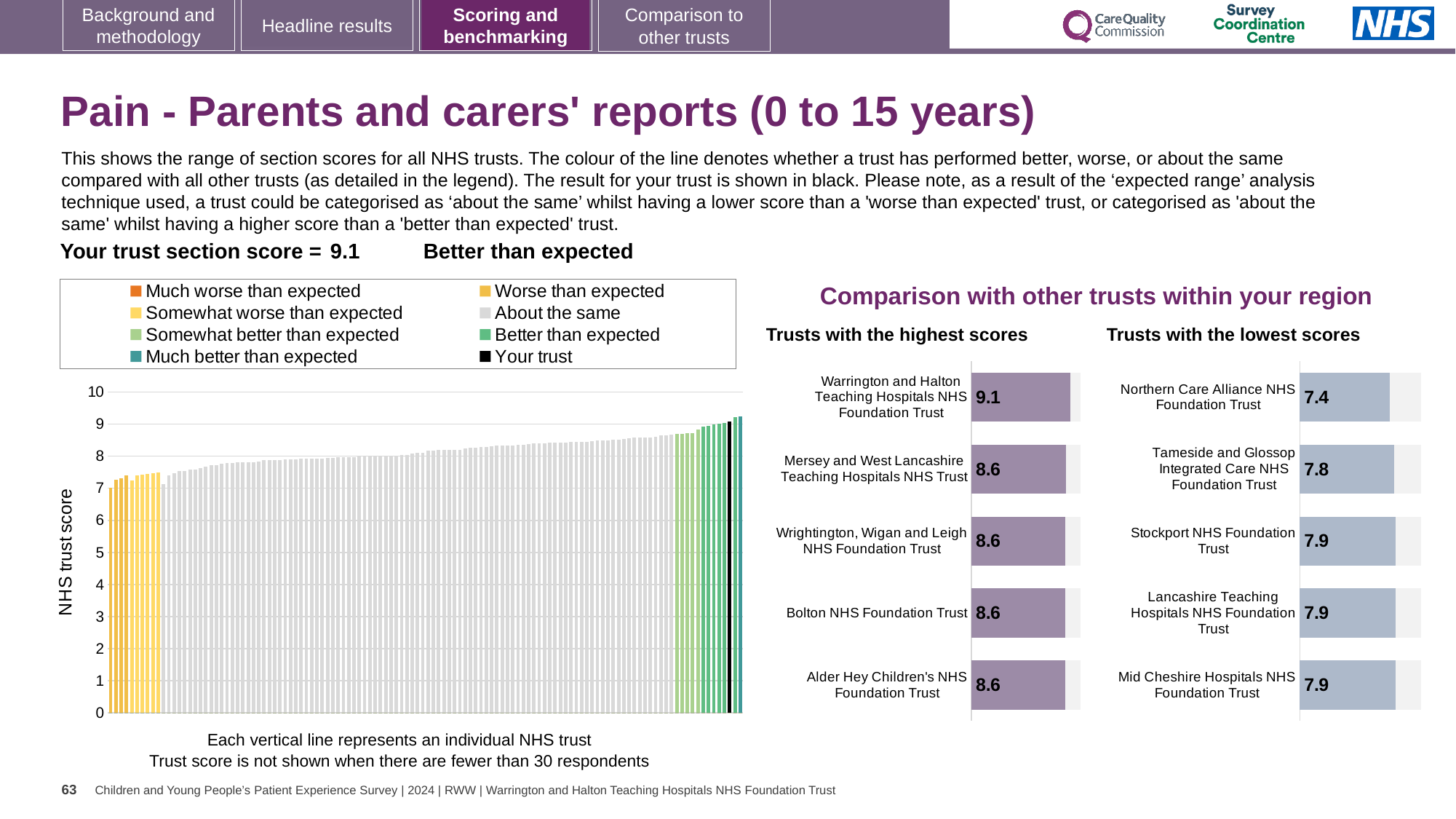
In the large chart on the left showing the range of section scores, are the values for the yellow (worse than expected) bars greater or less than 8? less How many entries does the legend of the large chart on the left list? 8 In the 'Trusts with the lowest scores' chart, which has the larger score: Stockport NHS Foundation Trust or Northern Care Alliance NHS Foundation Trust? Stockport NHS Foundation Trust In the 'Trusts with the lowest scores' chart, what is the score for Tameside and Glossop Integrated Care NHS Foundation Trust? 7.8 In the 'Trusts with the highest scores' chart, which trust has the highest score? Warrington and Halton Teaching Hospitals NHS Foundation Trust In the 'Trusts with the highest scores' chart, what is the score for Warrington and Halton Teaching Hospitals NHS Foundation Trust? 9.1 In the 'Trusts with the lowest scores' chart, which trust has the lowest score? Northern Care Alliance NHS Foundation Trust In the 'Trusts with the highest scores' chart, what is the score for Bolton NHS Foundation Trust? 8.6 In the 'Trusts with the lowest scores' chart, what is the score for Northern Care Alliance NHS Foundation Trust? 7.4 How many trusts are shown in the 'Trusts with the lowest scores' chart? 5 In the 'Trusts with the highest scores' chart, what is the difference between the scores of Warrington and Halton Teaching Hospitals NHS Foundation Trust and Mersey and West Lancashire Teaching Hospitals NHS Trust? 0.5 What kind of chart is the large chart on the left showing the range of NHS trust scores? bar chart